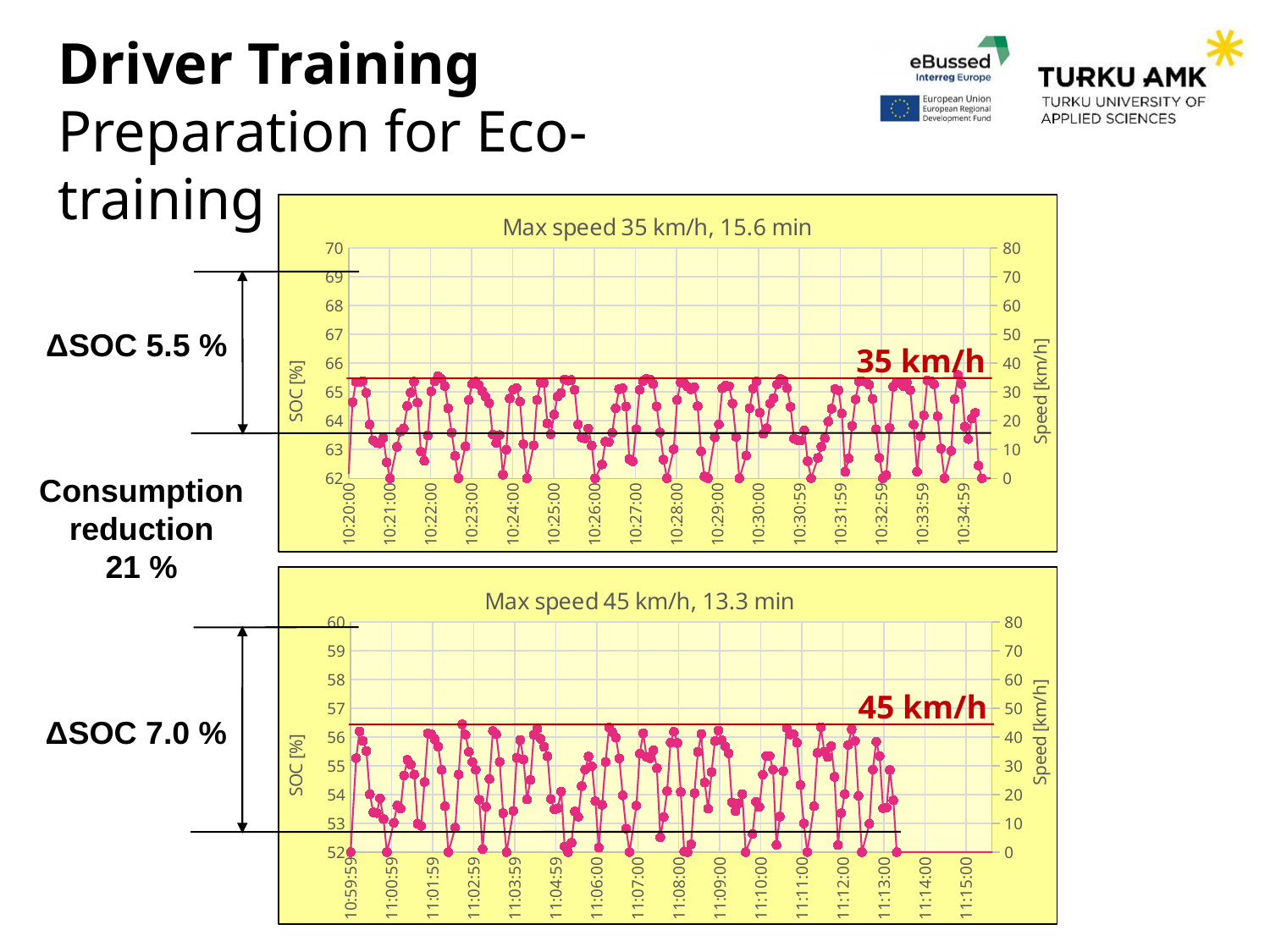
In the bottom chart, what is the speed value at 11:15:00? 0 What kind of chart is the top chart titled "Max speed 35 km/h, 15.6 min"? Line chart Which chart has the higher max speed line, the top chart or the bottom chart? The bottom chart (45 km/h) What is the highest value shown on the right-hand Speed axis of the bottom chart? 80 In the top chart, what speed value is marked by the red horizontal line? 35 km/h What is the label of the right-hand vertical axis in the top chart? Speed [km/h] In the bottom chart, is the speed value at 11:14:00 greater or less than 10 km/h? less How many time labels are shown on the x axis of the top chart? 16 In the bottom chart, what speed value is marked by the red horizontal line? 45 km/h What is the title of the bottom chart? Max speed 45 km/h, 13.3 min What is the first time label on the x axis of the bottom chart? 10:59:59 What is the lowest value shown on the left-hand SOC axis of the top chart? 62